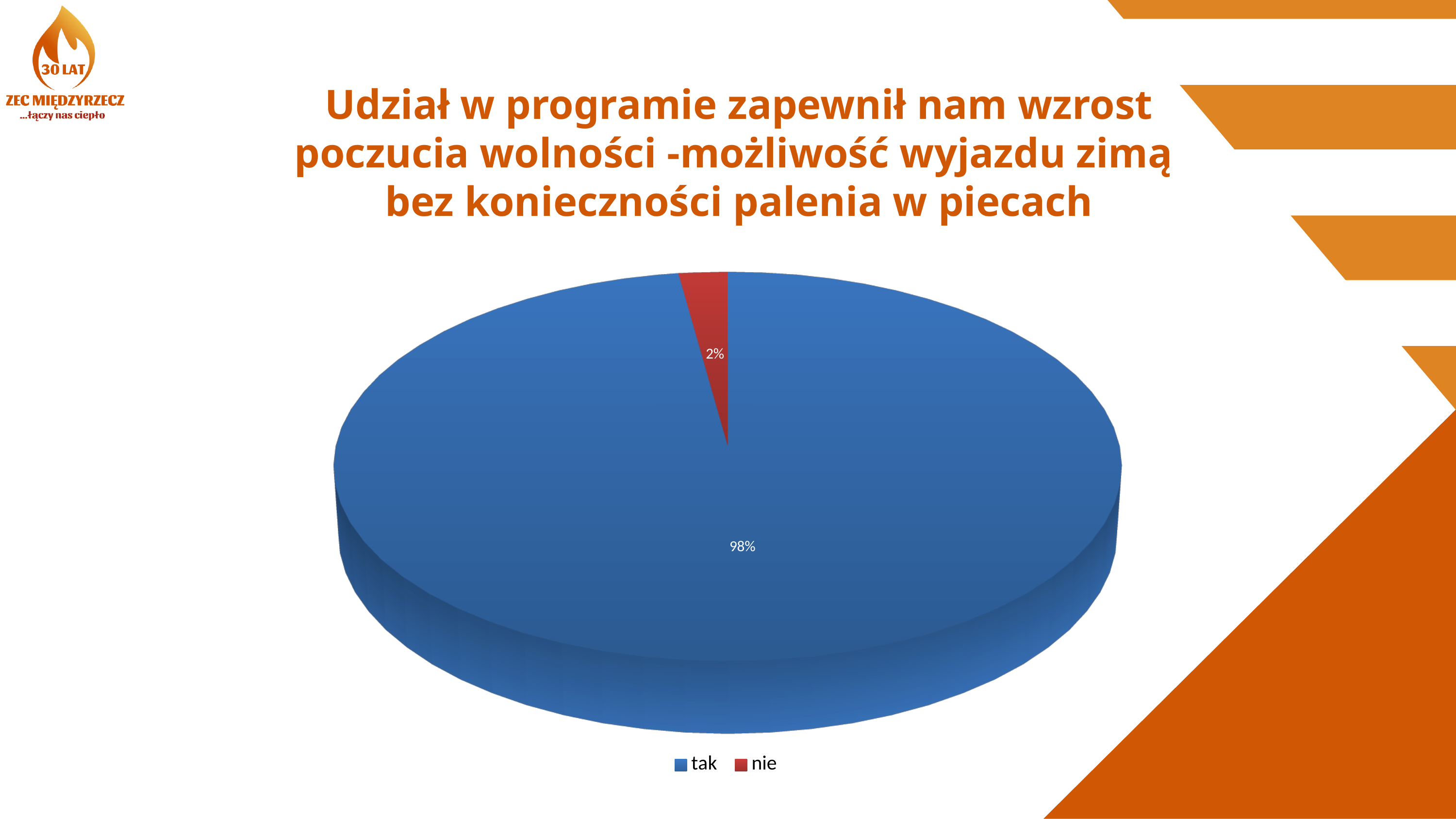
What colour is the "nie" slice? red How many entries does the legend list? 2 What is the difference in percentage points between the "tak" and "nie" slices? 96 How many categories are shown in the pie chart? 2 What share of the pie does "nie" represent? 2% What kind of chart is shown on the slide? pie chart Which slice is larger, "tak" or "nie"? tak What share of the pie does "tak" represent? 98% What colour is the "tak" slice? blue Which category has the largest slice of the pie? tak Which category has the smallest slice of the pie? nie